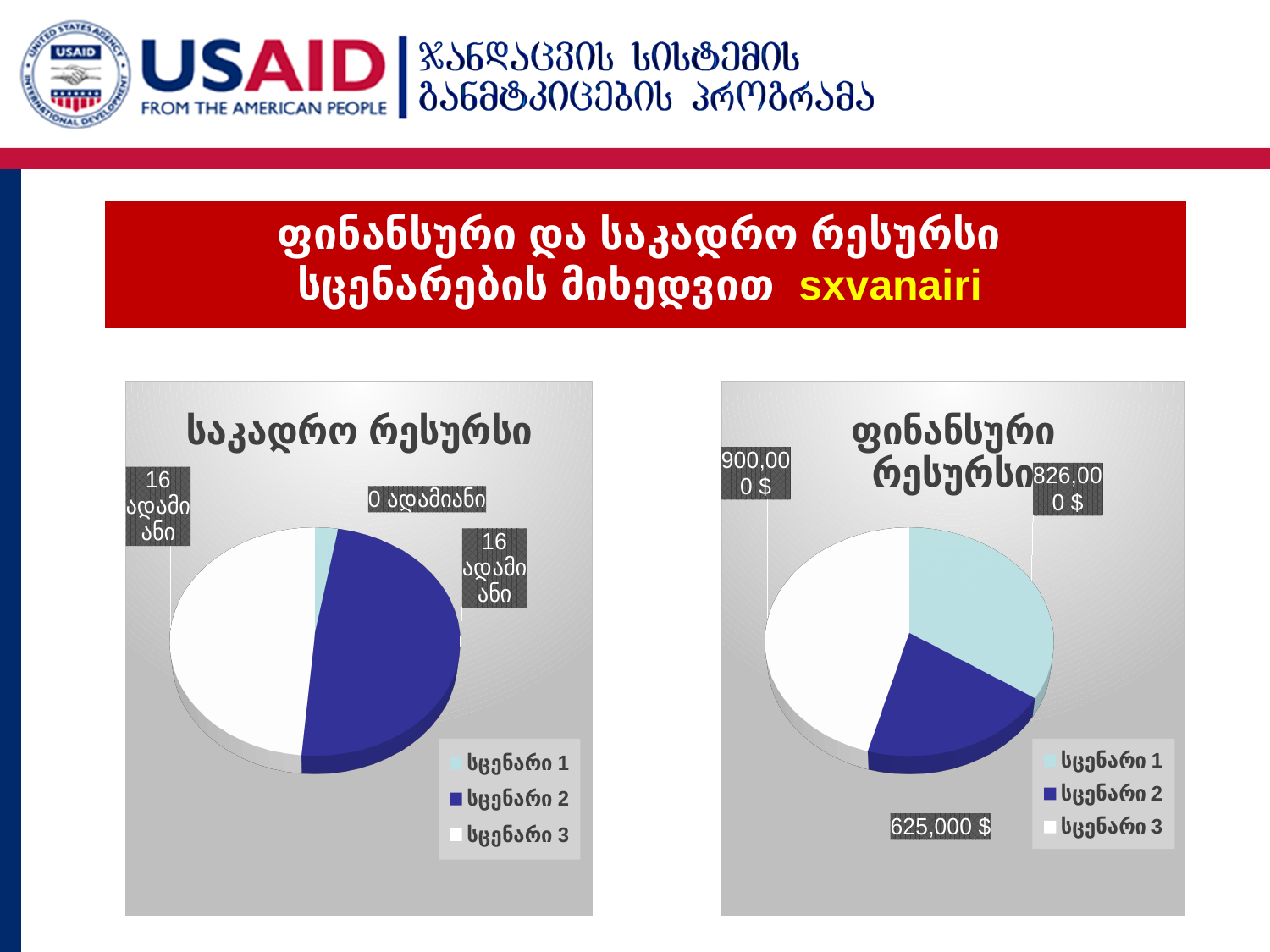
In the right chart "ფინანსური რესურსი", which scenario has the largest value? სცენარი 3 In the right chart "ფინანსური რესურსი", what is the value for სცენარი 3 (the white slice)? 900,000 $ In the right chart "ფინანსური რესურსი", what is the value for სცენარი 2 (the dark blue slice)? 625,000 $ In the right chart "ფინანსური რესურსი", what is the difference between the values for სცენარი 3 and სცენარი 2? 275,000 $ What type of chart is the right chart titled "ფინანსური რესურსი"? pie chart What type of chart is the left chart titled "საკადრო რესურსი"? pie chart In the left chart "საკადრო რესურსი", what is the value for სცენარი 2 (the dark blue slice)? 16 ადამიანი How many entries does the legend of the left chart "საკადრო რესურსი" list? 3 In the right chart "ფინანსური რესურსი", what is the total of the three scenario values? 2,351,000 $ In the right chart "ფინანსური რესურსი", which scenario has the smallest value? სცენარი 2 In the right chart "ფინანსური რესურსი", what colour is the slice for სცენარი 2? dark blue In the right chart "ფინანსური რესურსი", what is the value for სცენარი 1 (the light blue slice)? 826,000 $